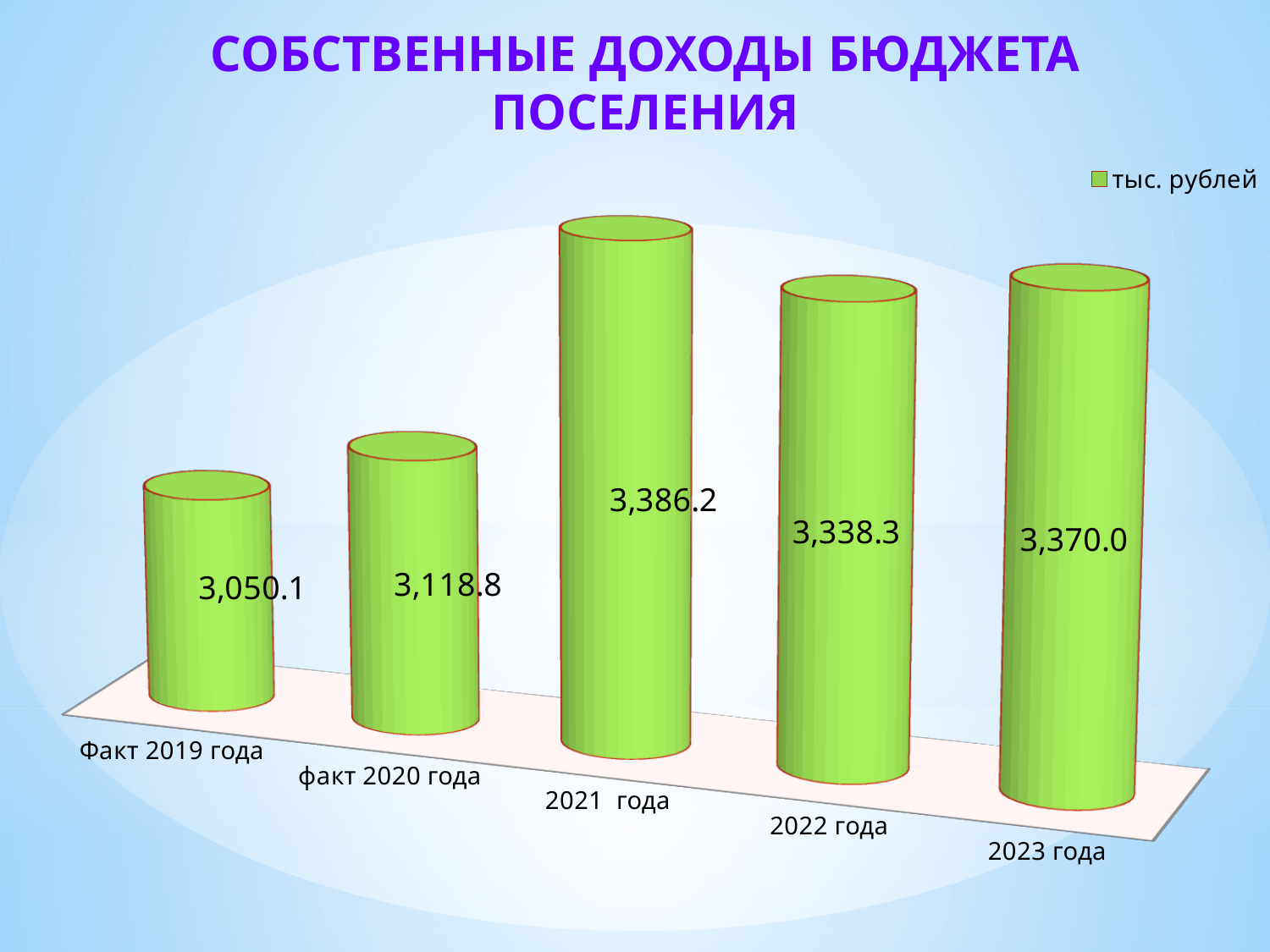
Which category has the lowest value? Факт 2019 года What is the value for 2021 года? 3,386.2 What is the difference between the values for 2023 года and 2022 года? 31.7 How many categories are shown on the chart? 5 What unit does the legend give for the values? тыс. рублей What is the difference between the values for 2021 года and Факт 2019 года? 336.1 Which category has the highest value? 2021 года What is the value for 2023 года? 3,370.0 Which is larger, the value for 2022 года or the value for 2023 года? 2023 года What kind of chart is shown on the slide? Bar chart What is the value for Факт 2019 года? 3,050.1 What is the value for факт 2020 года? 3,118.8